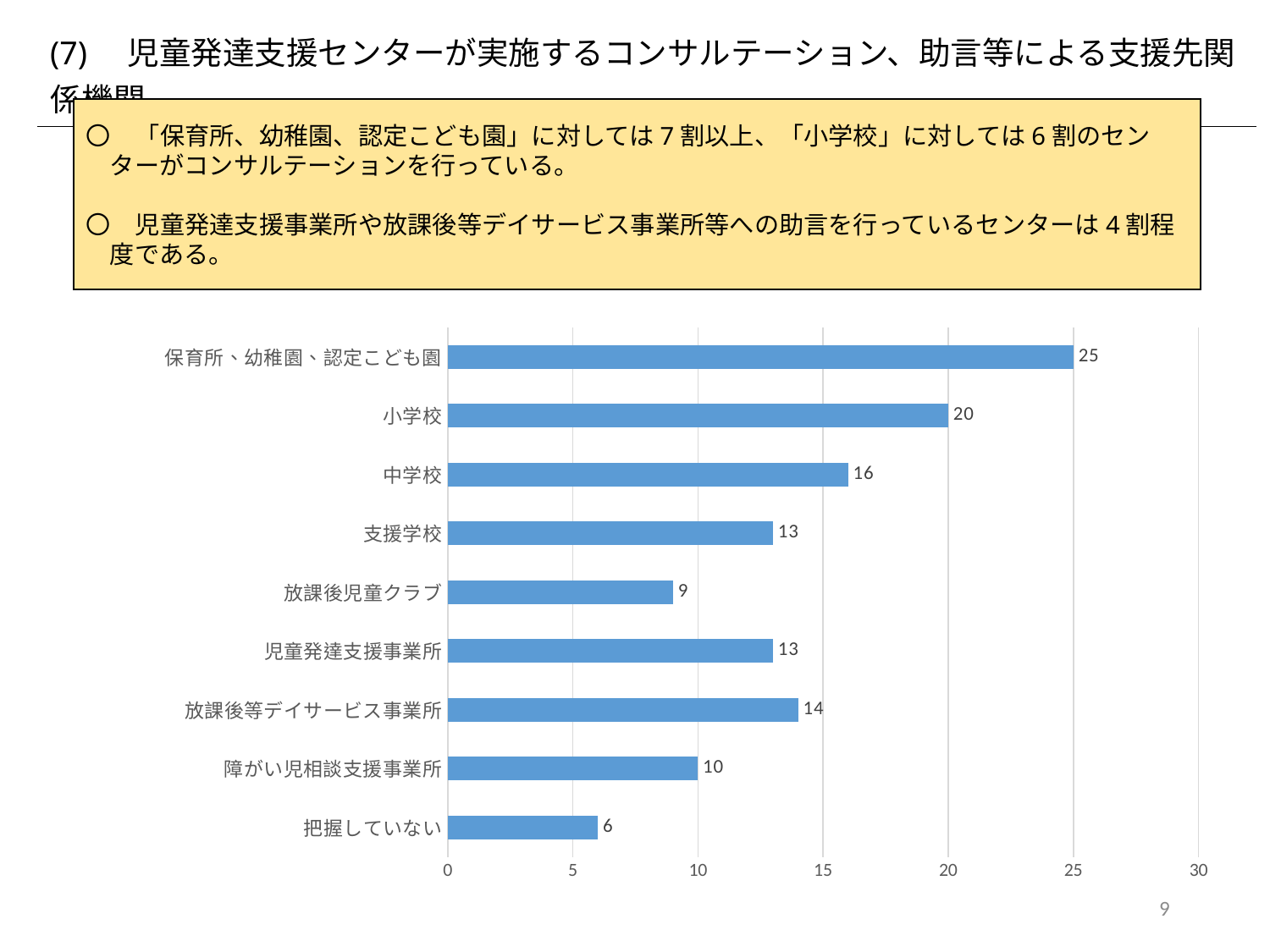
What is the value for 小学校? 20 What is the difference between the values for 保育所、幼稚園、認定こども園 and 小学校? 5 Is the value for 障がい児相談支援事業所 greater or less than 15? less What is the difference between the values for 放課後等デイサービス事業所 and 放課後児童クラブ? 5 How many categories are shown in the chart? 9 What is the value for 保育所、幼稚園、認定こども園? 25 Which is larger, the value for 中学校 or the value for 支援学校? 中学校 Which category has the lowest value? 把握していない What is the value for 把握していない? 6 What is the value for 放課後等デイサービス事業所? 14 What kind of chart is shown on the slide? bar chart Which category has the highest value? 保育所、幼稚園、認定こども園